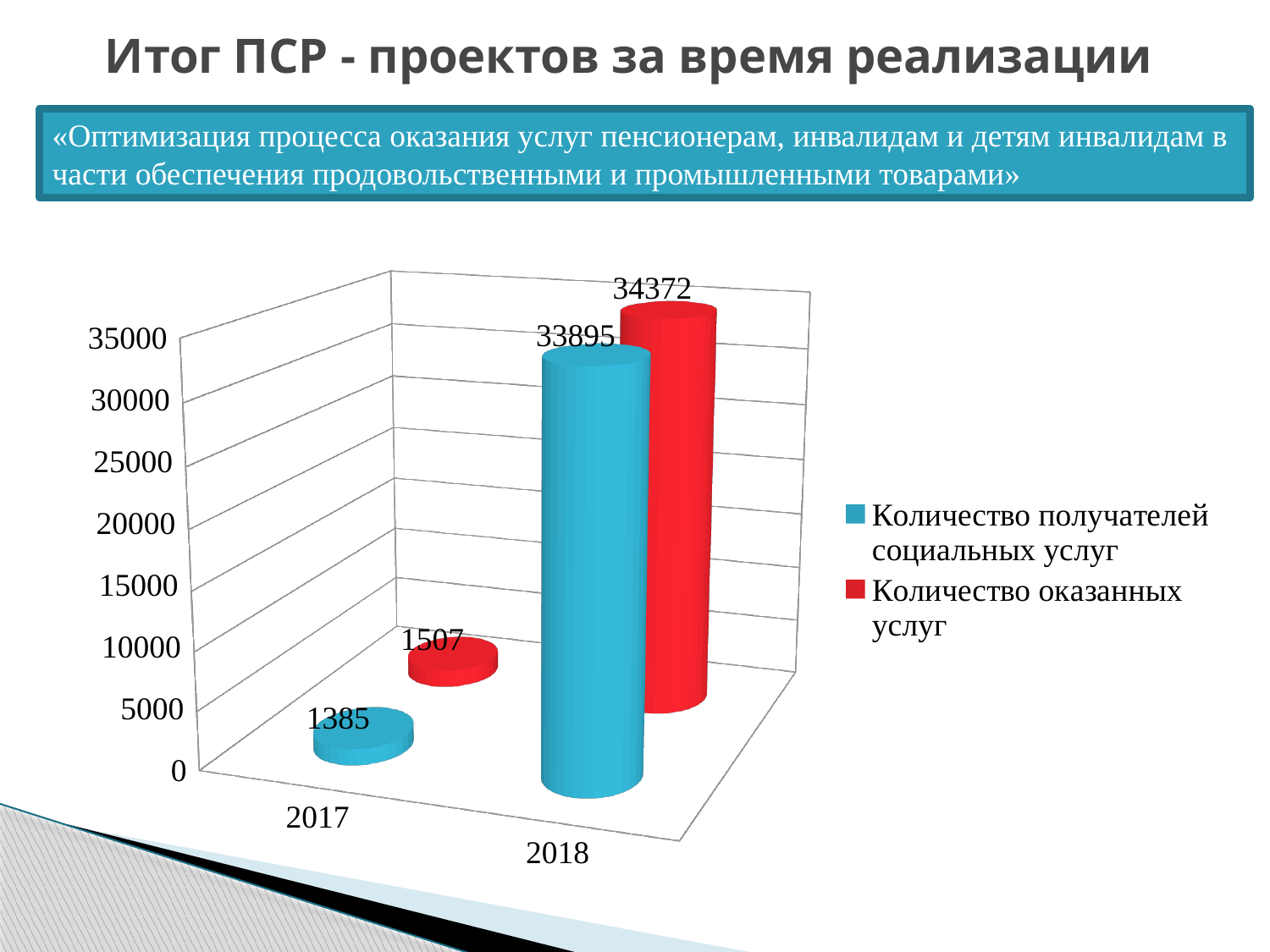
Which is larger in 2017: "Количество получателей социальных услуг" or "Количество оказанных услуг"? Количество оказанных услуг What is the value for "Количество оказанных услуг" in 2017? 1507 What is the value for "Количество оказанных услуг" in 2018? 34372 Which year has the lowest value for "Количество получателей социальных услуг"? 2017 Does the value for "Количество оказанных услуг" rise or fall from 2017 to 2018? rise What is the difference between "Количество оказанных услуг" and "Количество получателей социальных услуг" in 2018? 477 What is the value for "Количество получателей социальных услуг" in 2017? 1385 How many years are shown on the x axis? 2 How many series does the legend list? 2 What is the value for "Количество получателей социальных услуг" in 2018? 33895 Which year has the highest value for "Количество оказанных услуг"? 2018 What is the difference between the 2018 and 2017 values for "Количество получателей социальных услуг"? 32510